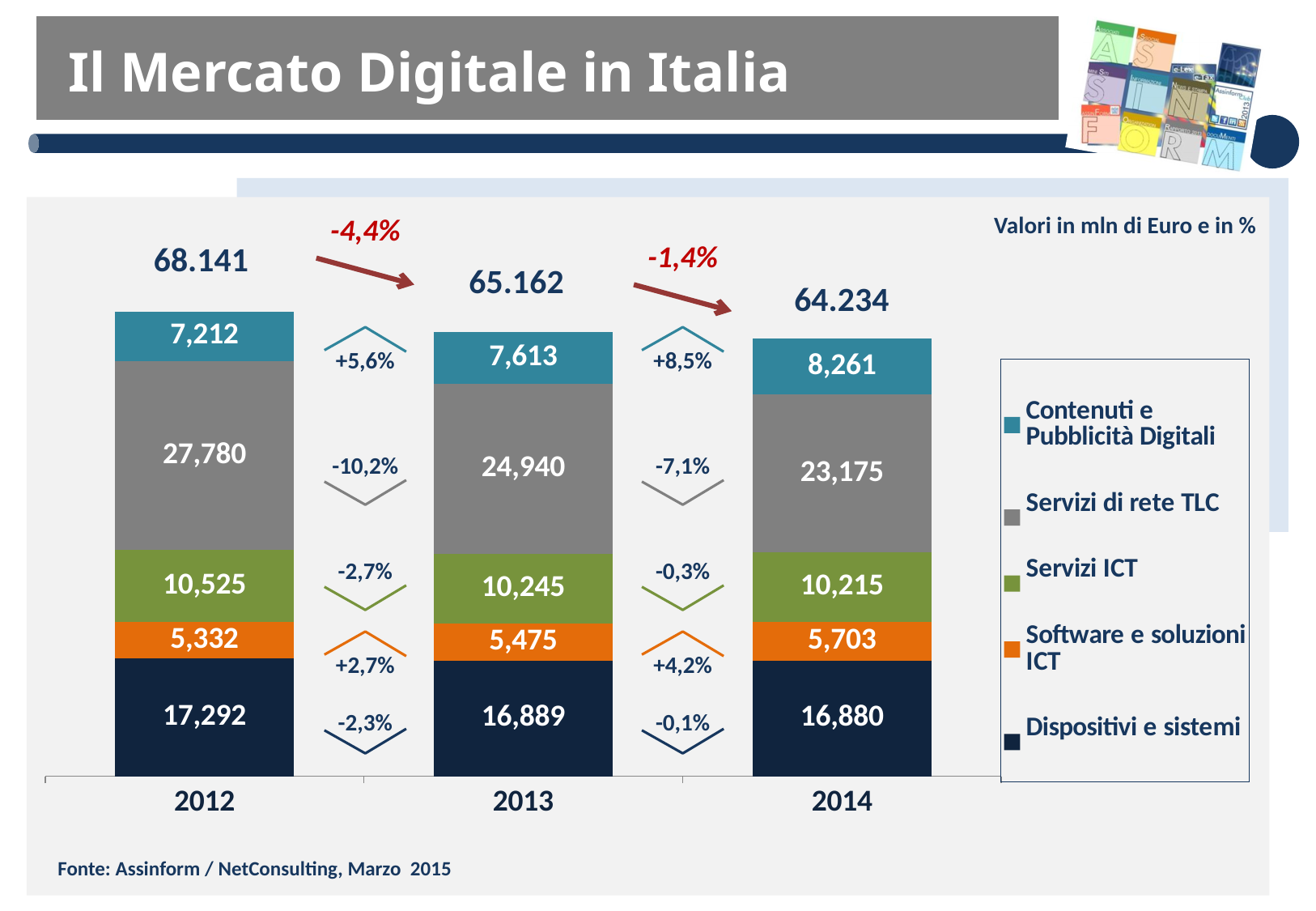
What kind of chart is shown on the slide? Stacked bar chart Which segment has the lowest value in the 2014 bar? Software e soluzioni ICT How many years are shown on the x axis? 3 How many series does the legend list? 5 Do the total values rise or fall from 2012 to 2014? Fall What is the value for Dispositivi e sistemi in 2014? 16,880 What is the value for Servizi di rete TLC in 2013? 24,940 In 2013, which is larger: Servizi ICT or Software e soluzioni ICT? Servizi ICT What is the difference between the Servizi di rete TLC value in 2012 and in 2014? 4,605 What is the total of the stacked bar for 2012? 68.141 What is the value for Contenuti e Pubblicità Digitali in 2012? 7,212 Which year has the highest total value? 2012